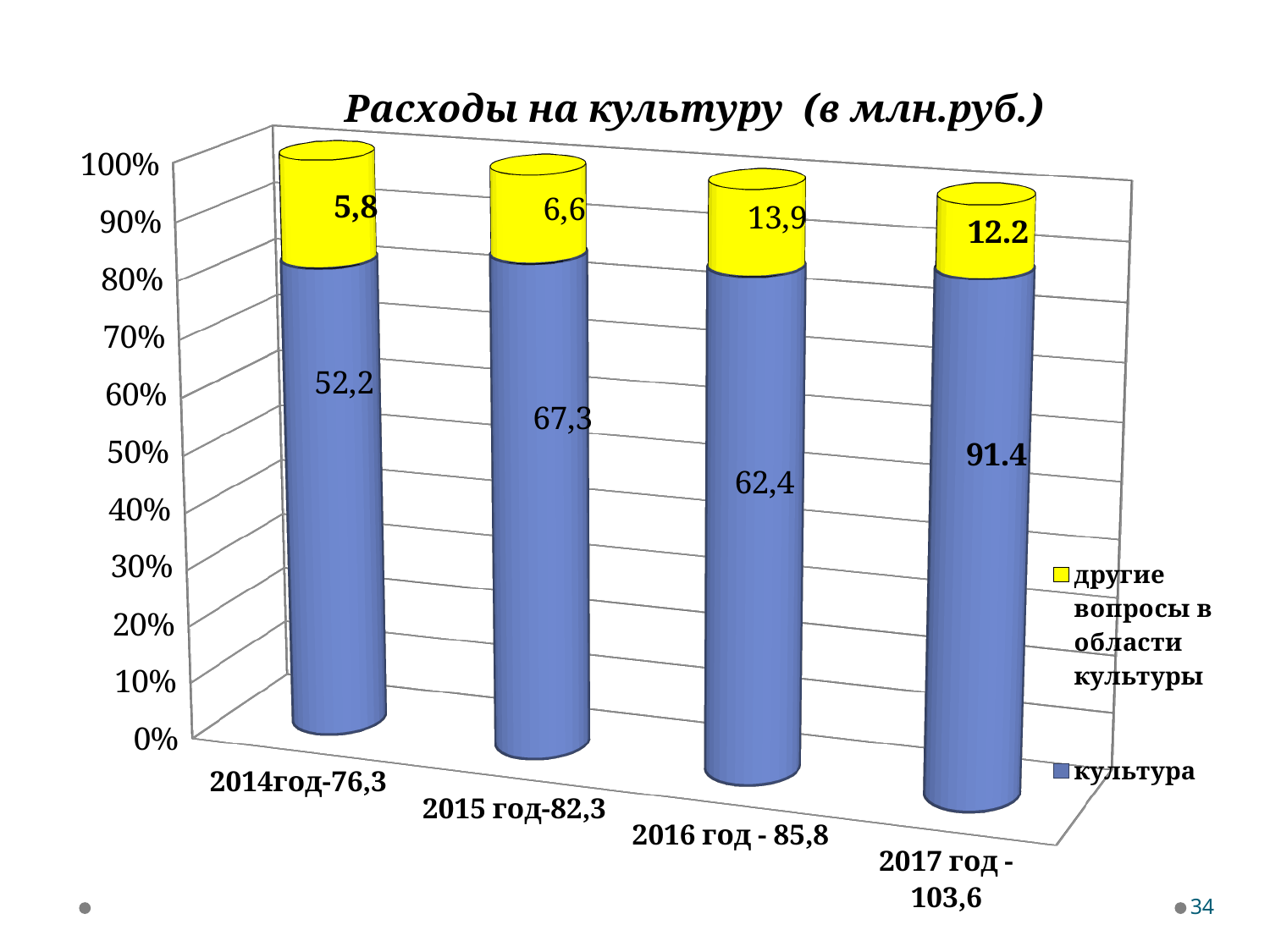
What is the value for другие вопросы в области культуры in 2016? 13,9 How many series does the legend list? 2 What kind of chart is shown on the slide? Stacked bar chart Which year has the larger value for другие вопросы в области культуры, 2016 or 2017? 2016 By how much does the value for культура in 2015 exceed the value for культура in 2014? 15,1 What is the value for культура in 2017? 91.4 In which year is the value for другие вопросы в области культуры the lowest? 2014 What is the difference between the values for другие вопросы в области культуры in 2016 and 2014? 8,1 How many years are shown on the x axis? 4 What is the value for другие вопросы в области культуры in 2015? 6,6 What is the value for культура in 2014? 52,2 In which year is the value for культура the highest? 2017